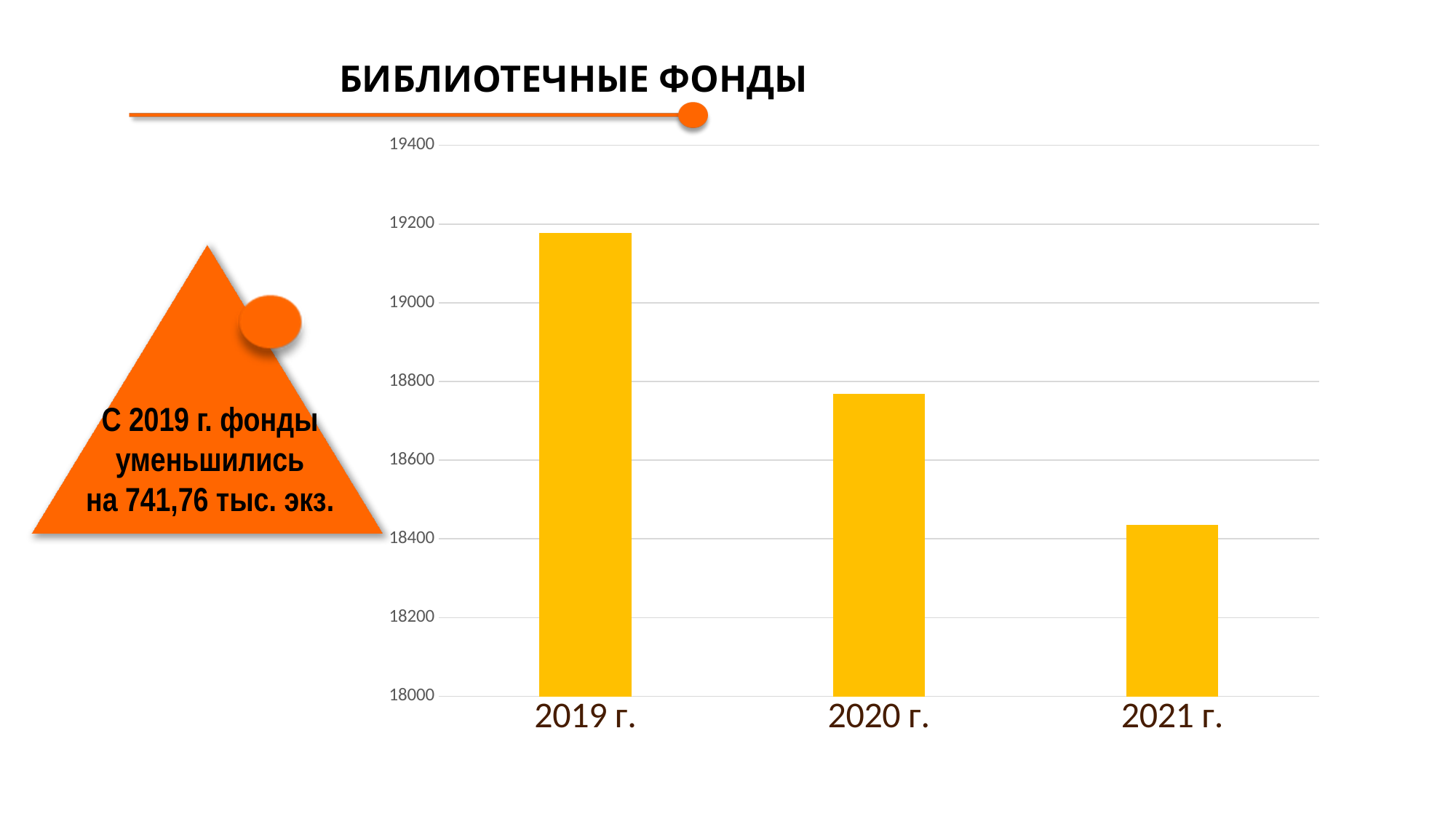
Is the value for 2020 г. greater or less than 18600? greater What colour are the bars in the chart? yellow Which is larger, the value for 2020 г. or the value for 2021 г.? 2020 г. What type of chart is shown on the slide? bar chart What is the title of the slide above the chart? БИБЛИОТЕЧНЫЕ ФОНДЫ Which year has the lowest value in the chart? 2021 г. Which year has the highest value in the chart? 2019 г. Is the value for 2021 г. greater or less than 18600? less Is the value for 2019 г. greater or less than 19000? greater Which is larger, the value for 2019 г. or the value for 2021 г.? 2019 г. How many years (categories) are shown on the x axis of the chart? 3 Do the values rise or fall from 2019 г. to 2021 г.? fall